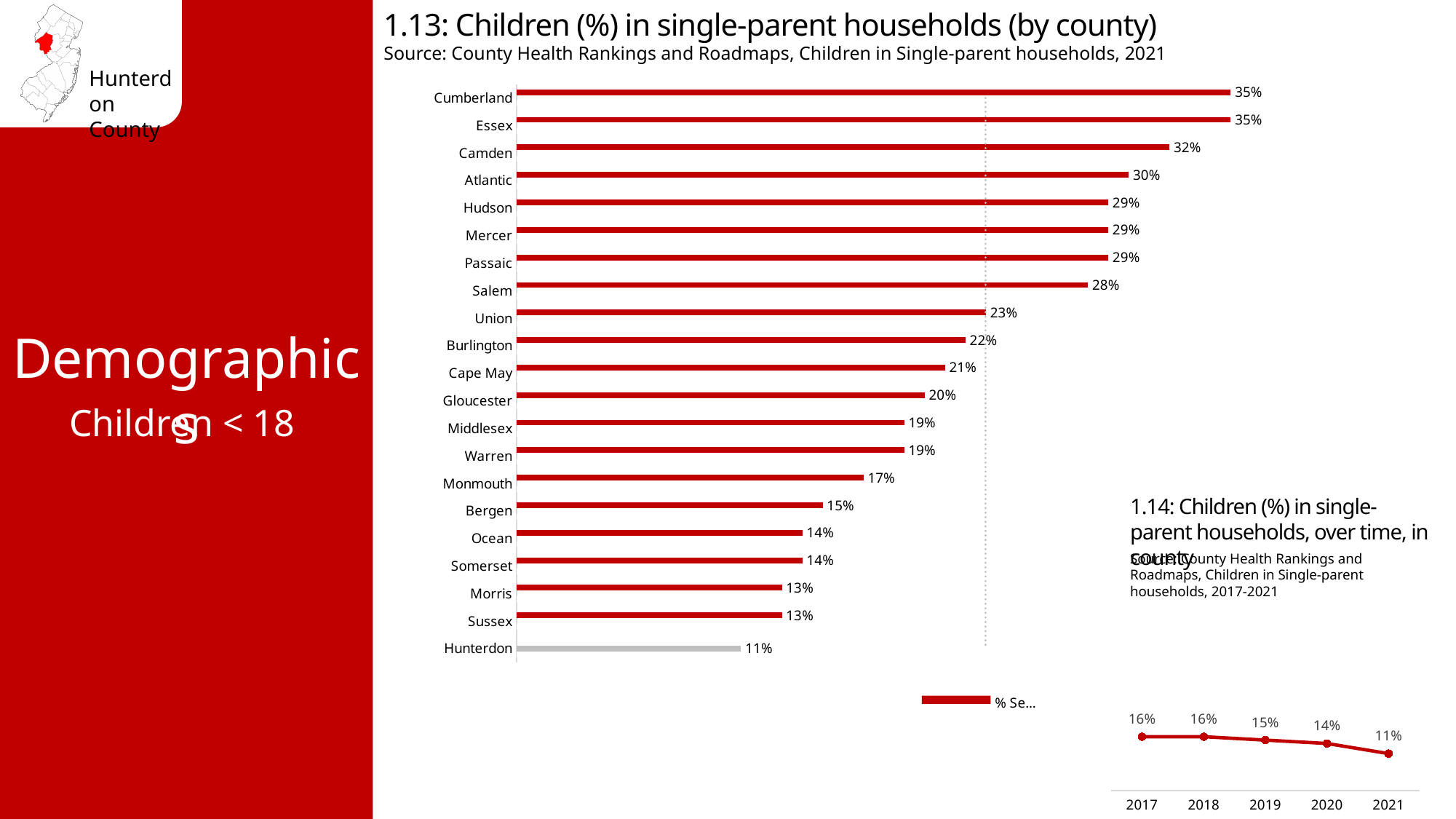
In chart 1.13 (by county), how many counties are shown? 21 In chart 1.13 (by county), which is larger, the value for Union or the value for Monmouth? Union In chart 1.13 (by county), what is the difference between Cumberland and Hunterdon? 24% In chart 1.14 (over time, in county), what is the difference between the 2017 and 2021 values? 5% In chart 1.14 (over time, in county), what is the value for 2019? 15% In chart 1.13 (Children (%) in single-parent households by county), what is the value for Hunterdon? 11% In chart 1.13 (by county), what is the value for Salem? 28% In chart 1.14 (over time, in county), do the values rise or fall from 2017 to 2021? Fall What kind of chart is chart 1.14 (over time, in county)? Line chart What kind of chart is chart 1.13 (by county)? Bar chart In chart 1.13 (by county), what is the value for Camden? 32% In chart 1.13 (by county), which county has the lowest value? Hunterdon